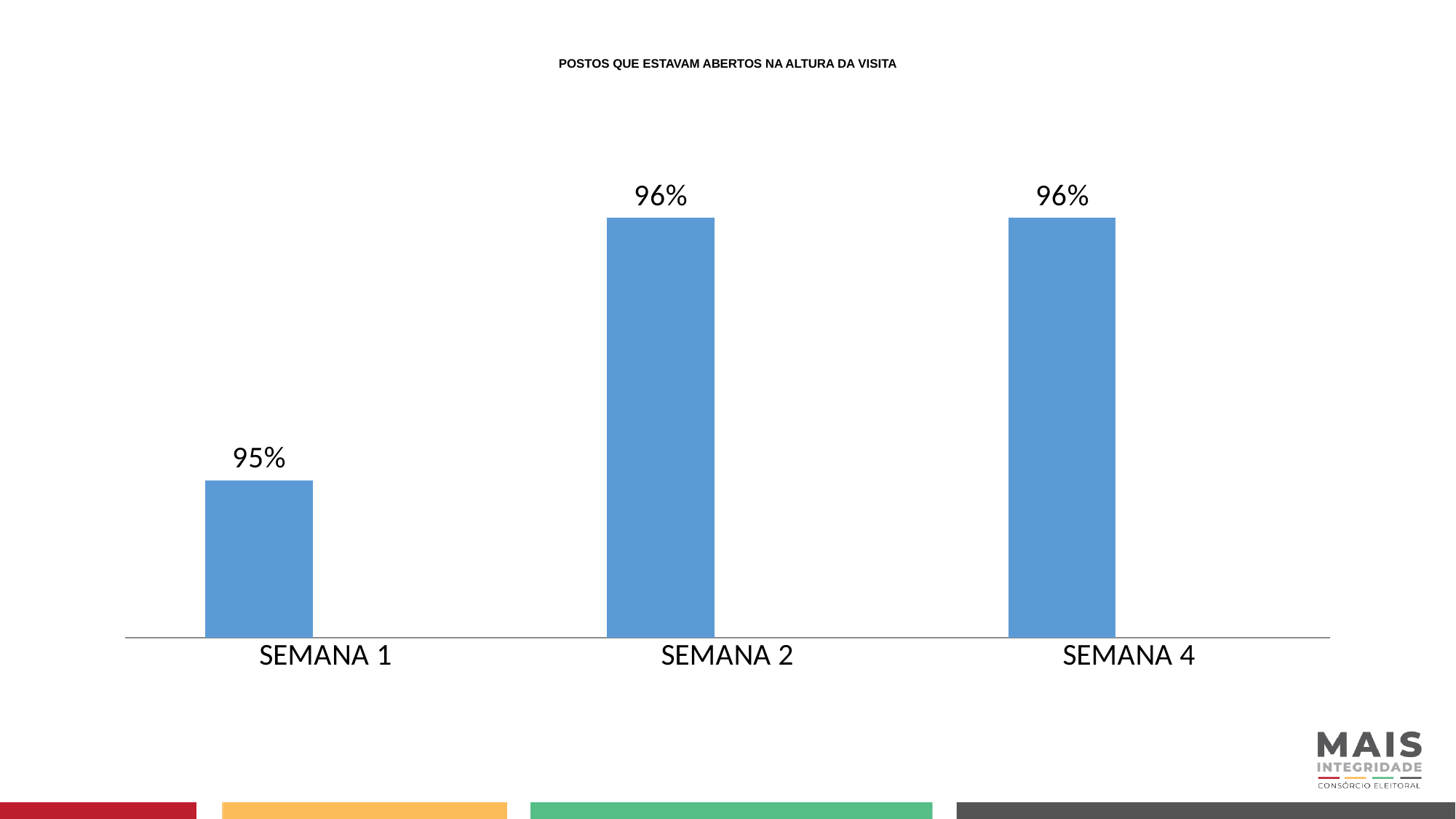
Which is larger, the value for SEMANA 1 or the value for SEMANA 4? SEMANA 4 What is the title of the chart? POSTOS QUE ESTAVAM ABERTOS NA ALTURA DA VISITA What is the value for SEMANA 2? 96% How many categories are shown on the x axis? 3 What kind of chart is shown on the slide? Bar chart Which category has the lowest value? SEMANA 1 What is the value for SEMANA 4? 96% Do the values rise or fall from SEMANA 1 to SEMANA 2? Rise What colour are the bars in the chart? Blue What is the value for SEMANA 1? 95% What is the difference between the values for SEMANA 2 and SEMANA 1? 1%